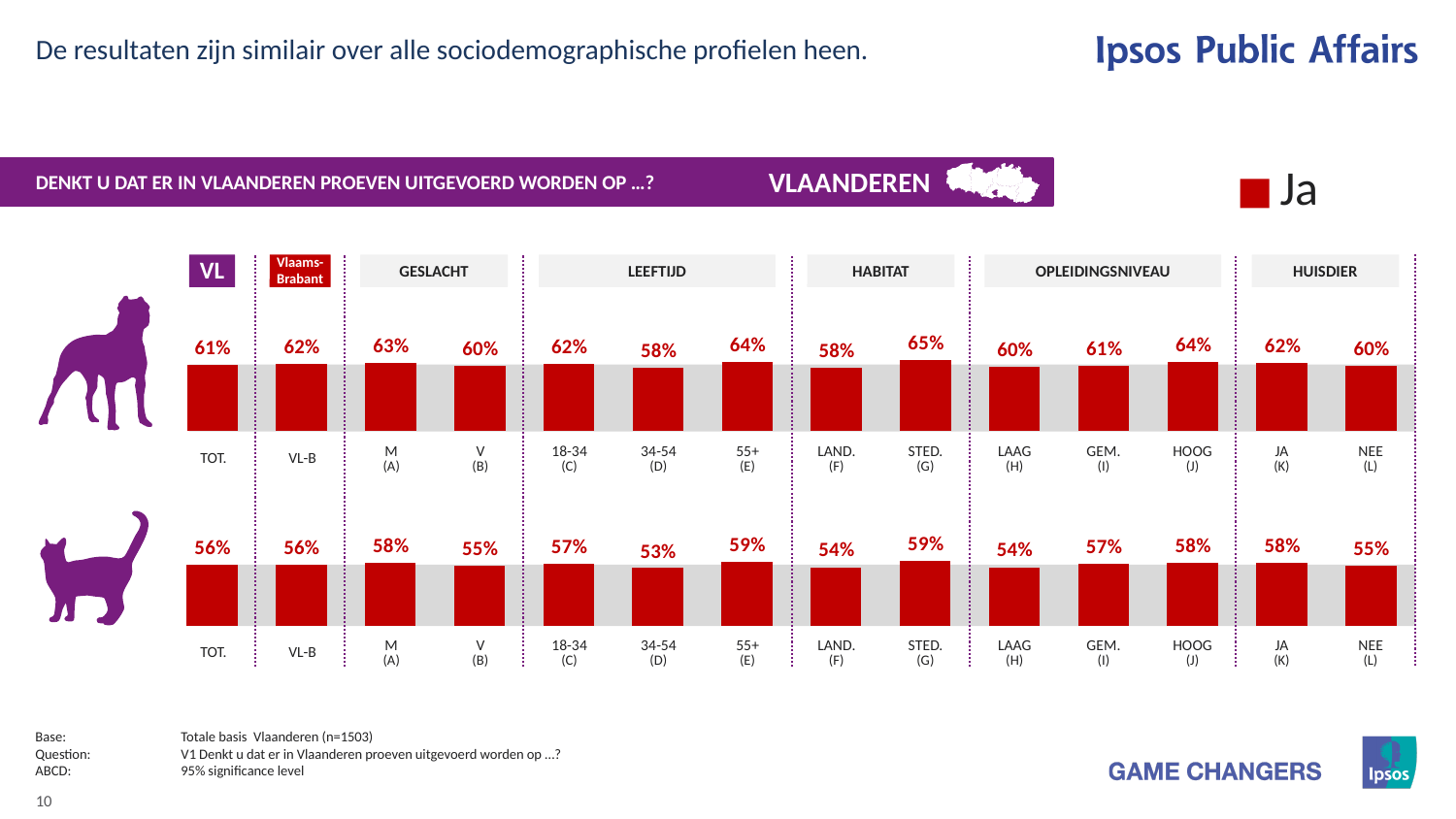
How many bars are in the top (dog) row? 14 In the bottom (cat) row of bars, which is larger: the value for 18-34 (C) or the value for 55+ (E)? 55+ (E) In the top (dog) row of bars, which category has the highest value? STED. (G) In the bottom (cat) row of bars, what is the value for STED. (G)? 59% In the top (dog) row of bars, what is the value for TOT.? 61% In the bottom (cat) row of bars, what is the difference between the values for JA (K) and NEE (L)? 3% What series does the legend on the slide list? Ja What kind of chart is used on this slide? Bar chart In the bottom (cat) row of bars, which category has the lowest value? 34-54 (D) In the top (dog) row of bars, what is the value for HOOG (J)? 64% In the top (dog) row of bars, what is the difference between the values for M (A) and V (B)? 3% In the bottom (cat) row of bars, what is the value for VL-B? 56%